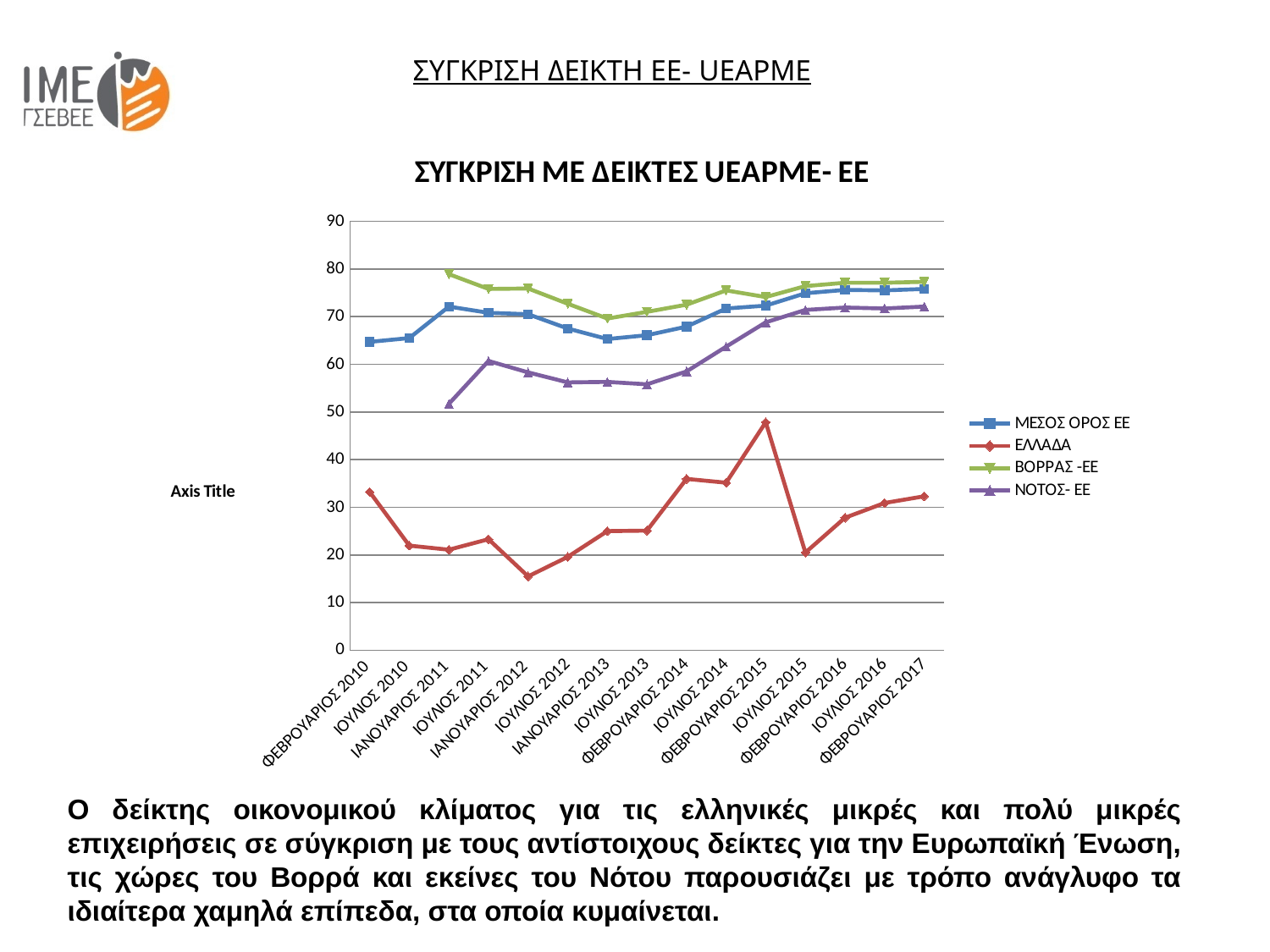
Which series has the lowest values throughout the chart? ΕΛΛΑΔΑ How many series does the legend list? 4 Is the value for ΝΟΤΟΣ- ΕΕ in ΙΑΝΟΥΑΡΙΟΣ 2011 greater or less than 60? less How many time points are shown on the x axis? 15 At which time point does the ΕΛΛΑΔΑ series reach its lowest value? ΙΑΝΟΥΑΡΙΟΣ 2012 Is the value for ΒΟΡΡΑΣ -ΕΕ in ΙΑΝΟΥΑΡΙΟΣ 2011 greater or less than 70? greater What is the title of the chart? ΣΥΓΚΡΙΣΗ ΜΕ ΔΕΙΚΤΕΣ UEAPME- ΕΕ Is the value for ΕΛΛΑΔΑ in ΙΑΝΟΥΑΡΙΟΣ 2012 greater or less than 20? less What kind of chart is shown on the slide? line chart In ΙΟΥΛΙΟΣ 2015, which is larger: the value for ΕΛΛΑΔΑ or the value for ΝΟΤΟΣ- ΕΕ? ΝΟΤΟΣ- ΕΕ At which time point does the ΕΛΛΑΔΑ series reach its highest value? ΦΕΒΡΟΥΑΡΙΟΣ 2015